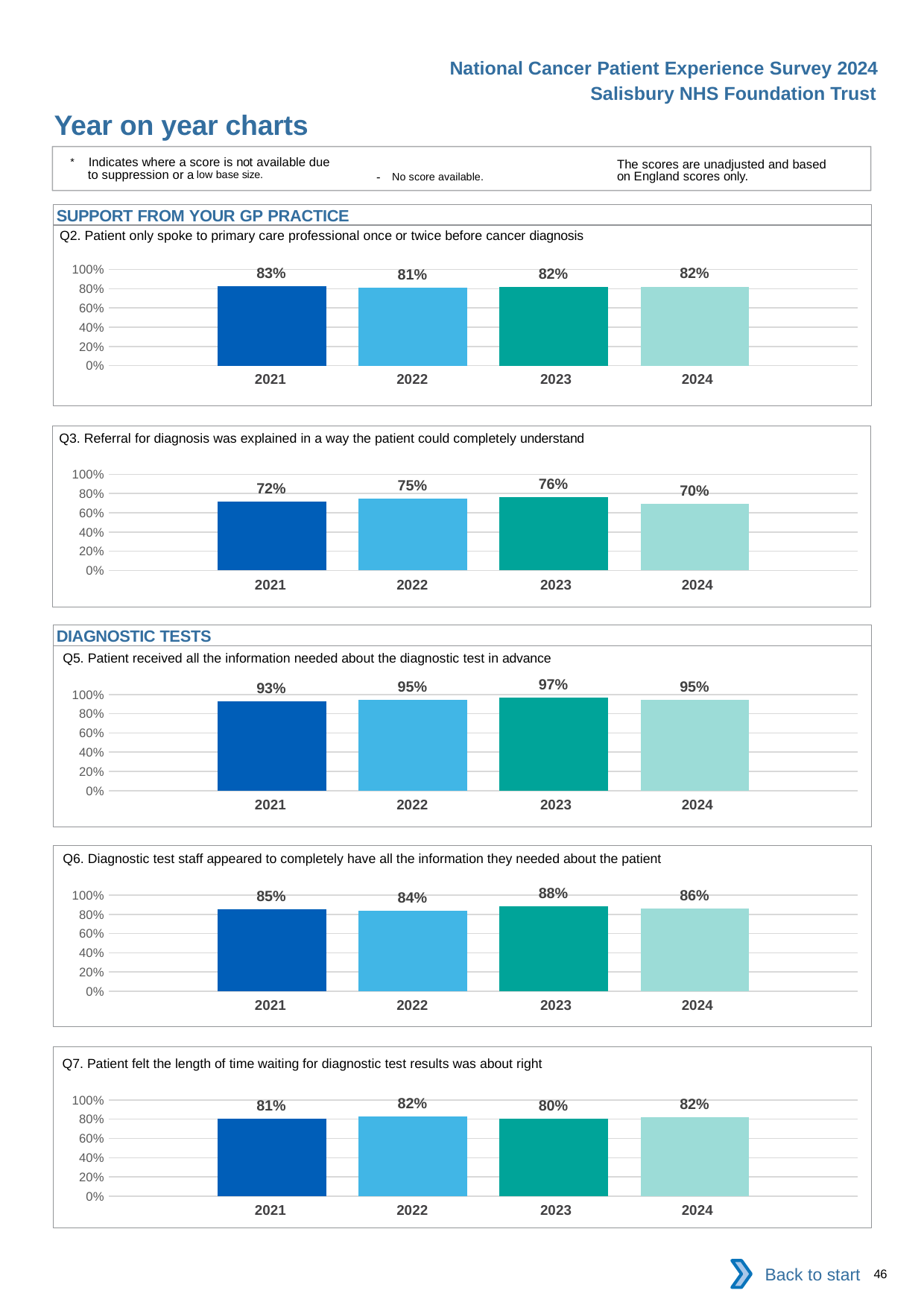
In the Q3 chart (referral for diagnosis was explained in a way the patient could completely understand), which year has the highest value? 2023 In the Q6 chart (diagnostic test staff appeared to completely have all the information they needed about the patient), which is larger, the value for 2023 or the value for 2022? 2023 In the Q7 chart (patient felt the length of time waiting for diagnostic test results was about right), what is the difference between the 2022 and 2023 values? 2 percentage points What kind of chart is the Q5 chart (patient received all the information needed about the diagnostic test in advance)? Bar chart In the Q5 chart (patient received all the information needed about the diagnostic test in advance), do the values rise or fall from 2021 to 2023? rise In the Q2 chart (patient only spoke to primary care professional once or twice before cancer diagnosis), what is the value for 2021? 83% In the Q5 chart (patient received all the information needed about the diagnostic test in advance), what is the difference between the 2023 and 2021 values? 4 percentage points In the Q6 chart (diagnostic test staff appeared to completely have all the information they needed about the patient), what is the value for 2024? 86% In the Q3 chart (referral for diagnosis was explained in a way the patient could completely understand), which year has the lowest value? 2024 How many years are shown on the x axis of the Q2 chart (patient only spoke to primary care professional once or twice before cancer diagnosis)? 4 In the Q7 chart (patient felt the length of time waiting for diagnostic test results was about right), what is the value for 2023? 80% In the Q3 chart (referral for diagnosis was explained in a way the patient could completely understand), is the value for 2024 greater or less than 80%? less